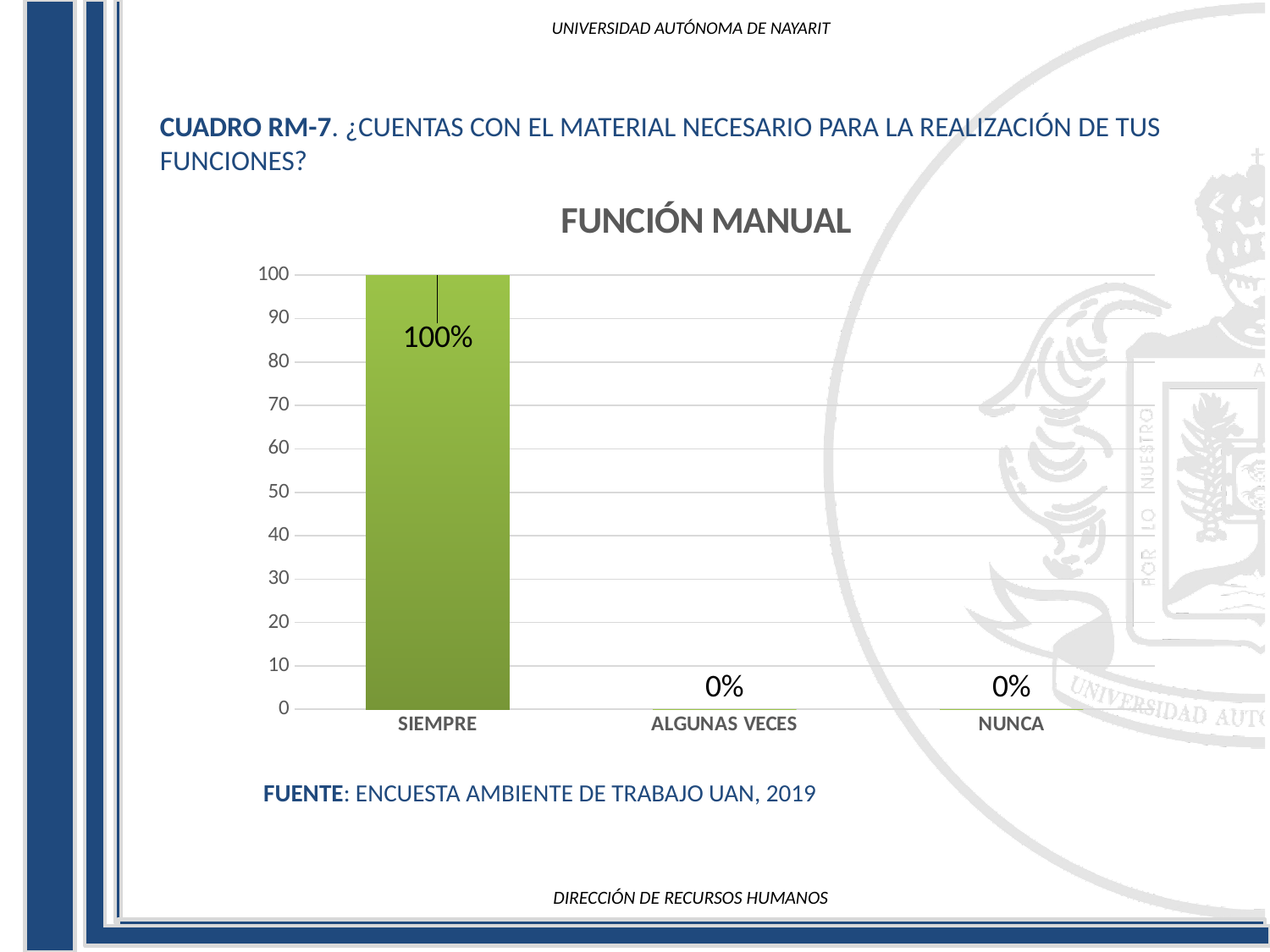
What kind of chart is shown on the slide? bar chart Do the values rise or fall from SIEMPRE to NUNCA along the x axis? fall Which category has the highest value? SIEMPRE What is the value for NUNCA? 0% What is the value for ALGUNAS VECES? 0% What is the highest value shown on the y axis? 100 How many categories are shown on the x axis? 3 Is the value for SIEMPRE greater or less than 50? greater What is the value for SIEMPRE? 100% Which is larger, the value for SIEMPRE or the value for ALGUNAS VECES? SIEMPRE What is the title of the chart? FUNCIÓN MANUAL What is the difference between the values for SIEMPRE and NUNCA? 100%